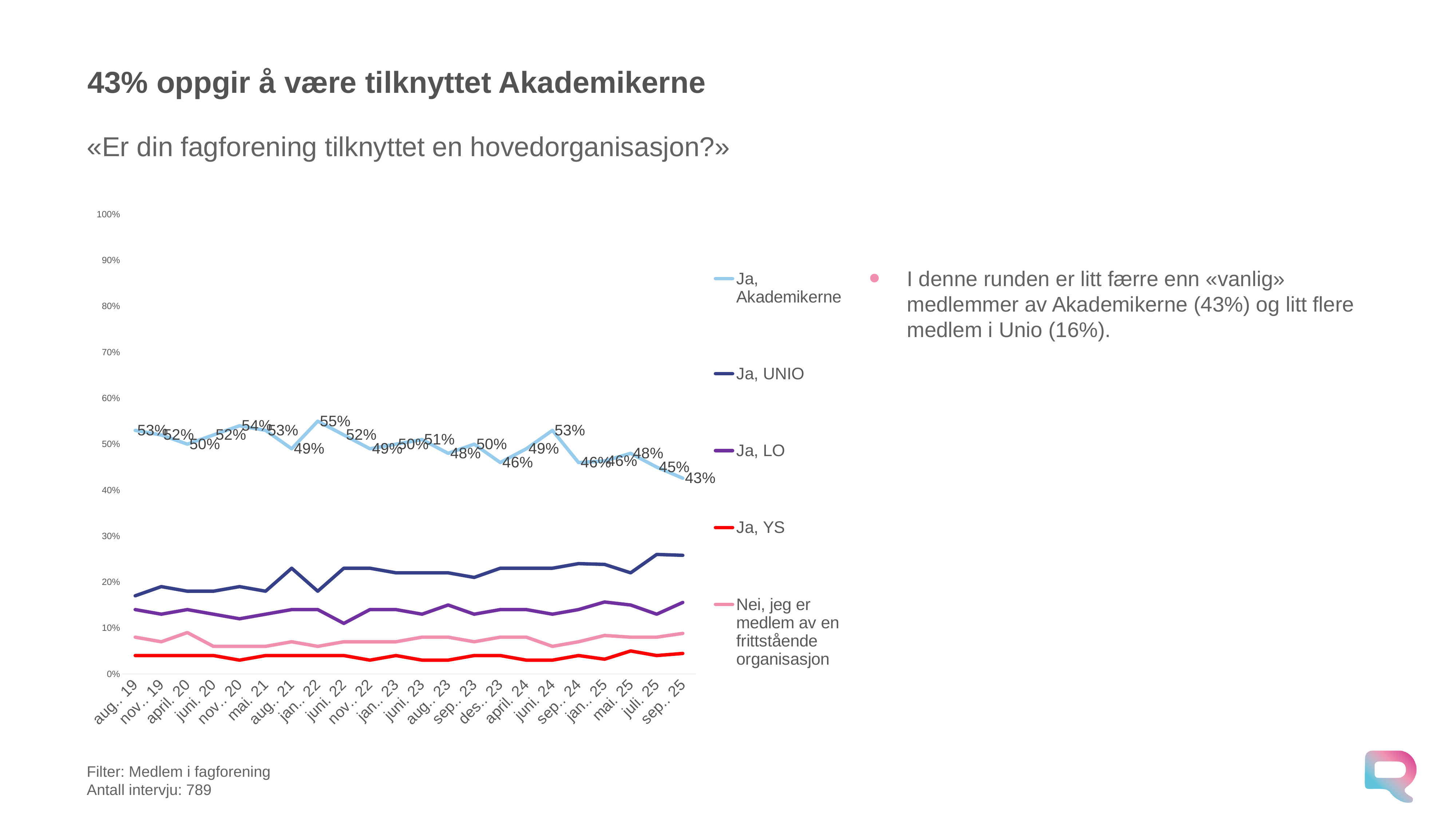
What is the value for Ja, Akademikerne at jan.. 22? 55% Is the value for Ja, YS at sep.. 25 greater or less than 10%? less How many time points are shown on the x axis? 22 Which is larger for Ja, Akademikerne: the value at juni. 24 or at sep.. 24? juni. 24 Does the Ja, Akademikerne series generally rise or fall from aug.. 19 to sep.. 25? Fall What is the difference between the Ja, Akademikerne values at jan.. 22 and sep.. 25? 12 percentage points At which time point is the Ja, Akademikerne series highest? jan.. 22 What is the value for Ja, Akademikerne at sep.. 25? 43% How many series does the legend list? 5 At which time point is the Ja, Akademikerne series lowest? sep.. 25 Is the value for Ja, UNIO at sep.. 25 greater or less than 20%? greater What kind of chart is shown on the slide? Line chart